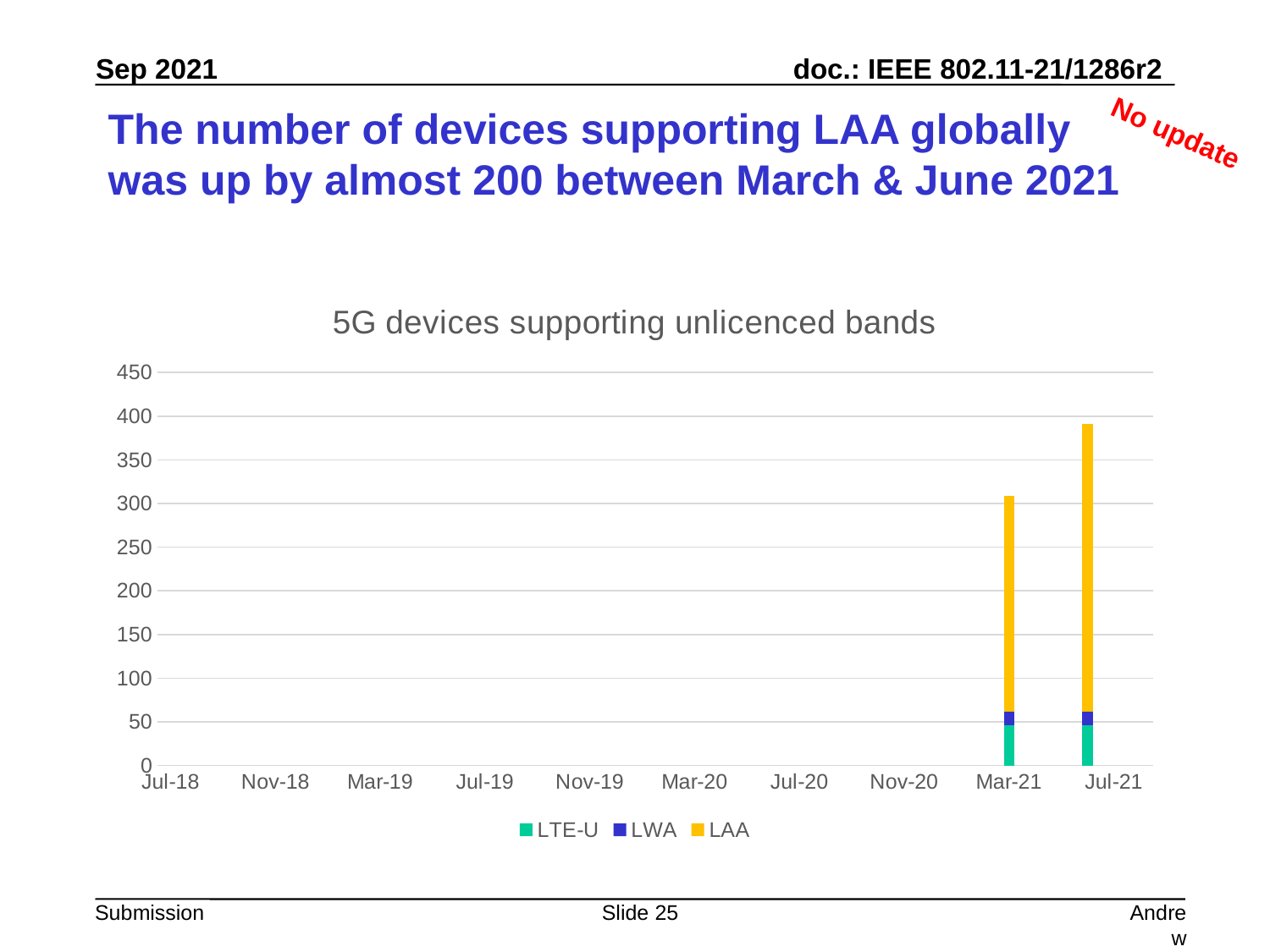
What is the title of the chart? 5G devices supporting unlicenced bands Which series are listed in the legend? LTE-U, LWA, LAA How many series does the legend list? 3 Which date has the shorter stacked bar, Mar-21 or Jul-21? Mar-21 How many dates have a bar plotted on the chart? 2 Is the total stacked bar for Jul-21 greater or less than 450? less Is the total stacked bar for Jul-21 greater or less than 350? greater Which series makes up the largest part of the Jul-21 bar? LAA Which date has the tallest stacked bar? Jul-21 Is the total stacked bar for Mar-21 greater or less than 250? greater What kind of chart is shown on the slide? stacked bar chart Do the stacked bar totals rise or fall from Mar-21 to Jul-21? rise